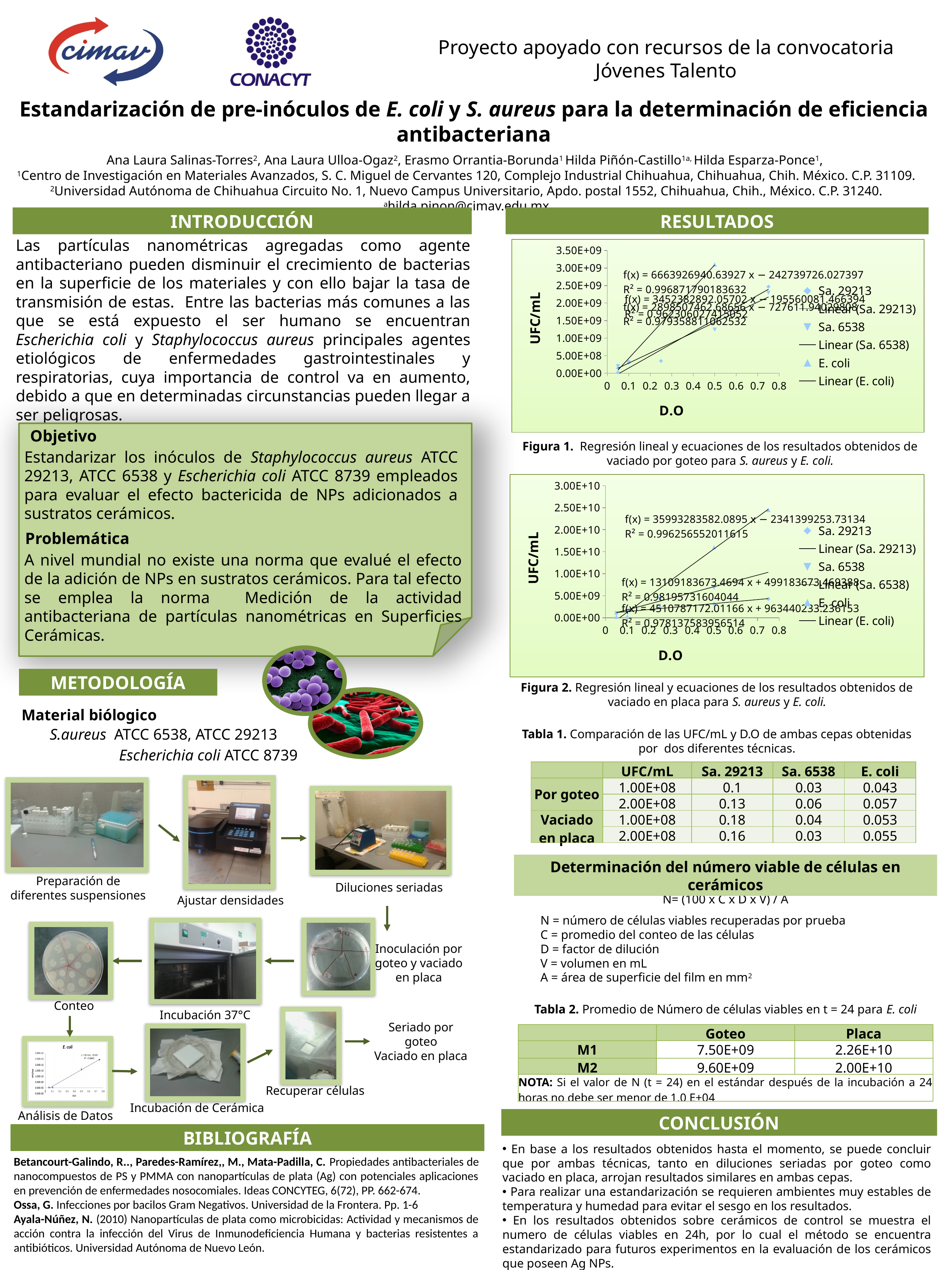
In Figura 2 (the lower chart), is the highest plotted UFC/mL value greater or less than 2.00E+10? greater In Figura 1 (the upper chart), is the highest plotted UFC/mL value greater or less than 2.50E+09? greater In Figura 1 (the upper chart), do the UFC/mL values rise or fall as D.O increases? rise In Figura 2 (the lower chart), do the UFC/mL values rise or fall as D.O increases? rise In Figura 1 (the upper chart), how many bacterial strains are plotted as data series (excluding the linear trendlines)? 3 How many entries does the legend of Figura 2 (the lower chart) list? 6 What kind of chart is Figura 1 (the upper chart under RESULTADOS)? scatter chart What is the highest R² value printed on Figura 2 (the lower chart)? 0.996256552011615 What is the x-axis title of Figura 2 (the lower chart)? D.O What is the y-axis title of Figura 1 (the upper chart)? UFC/mL How many entries does the legend of Figura 1 (the upper chart) list? 6 What is the highest R² value printed on Figura 1 (the upper chart)? 0.996871790183632